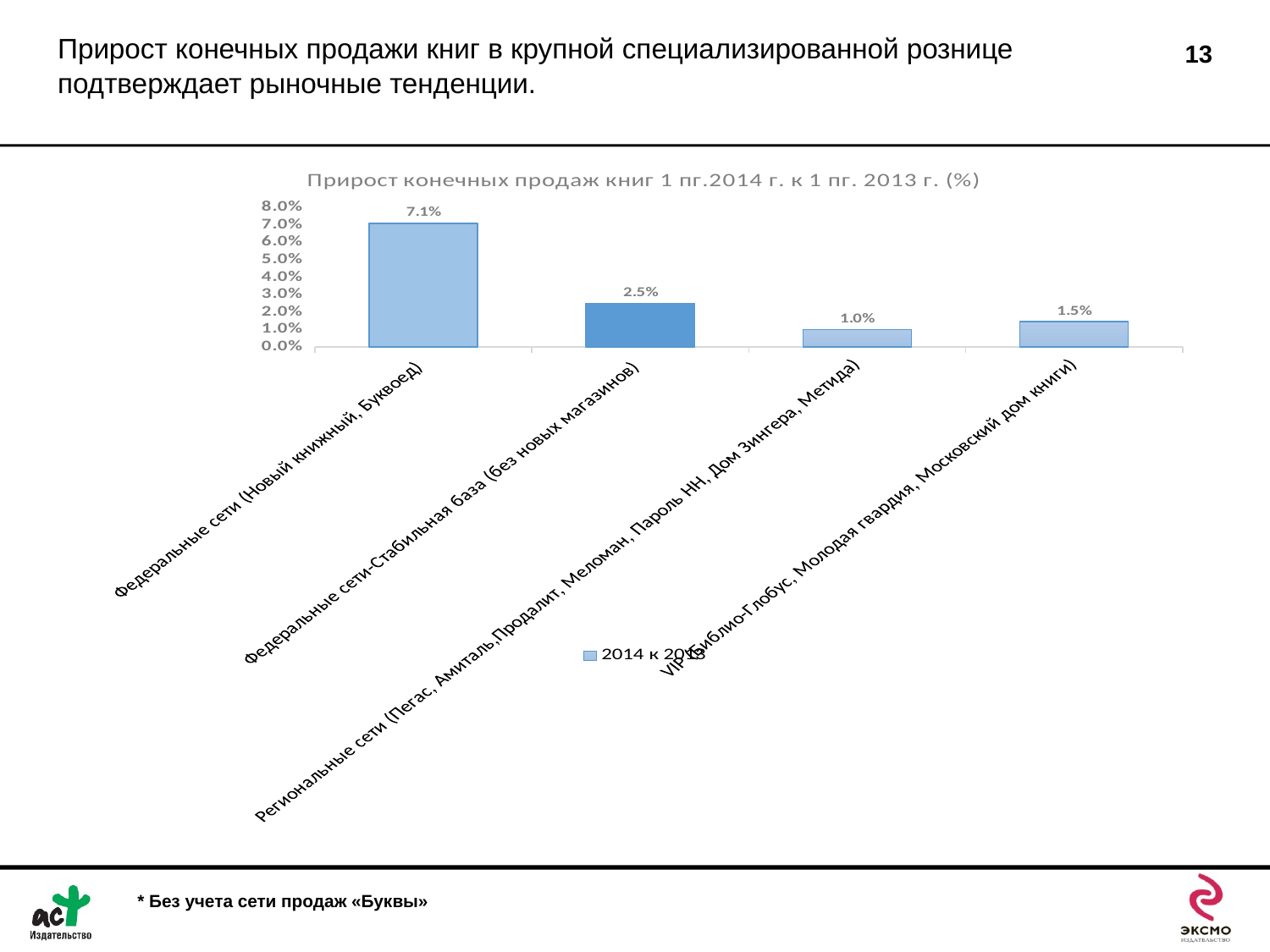
How many categories are shown in the chart? 4 What kind of chart is shown on the slide? Bar chart What is the value for VIP (Библио-Глобус, Молодая гвардия, Московский дом книги)? 1.5% Which category has the lowest value? Региональные сети (Пегас, Амиталь, Продалит, Меломан, Пароль НН, Дом Зингера, Метида) How many series does the legend list? 1 What is the value for Региональные сети (Пегас, Амиталь, Продалит, Меломан, Пароль НН, Дом Зингера, Метида)? 1.0% What is the difference between the value for Федеральные сети (Новый книжный, Буквоед) and the value for Федеральные сети-Стабильная база (без новых магазинов)? 4.6% Which category has the highest value? Федеральные сети (Новый книжный, Буквоед) What is the title of the chart? Прирост конечных продаж книг 1 пг.2014 г. к 1 пг. 2013 г. (%) Which is larger: the value for VIP (Библио-Глобус, Молодая гвардия, Московский дом книги) or the value for Региональные сети? VIP (Библио-Глобус, Молодая гвардия, Московский дом книги) What is the value for Федеральные сети (Новый книжный, Буквоед)? 7.1% What is the value for Федеральные сети-Стабильная база (без новых магазинов)? 2.5%